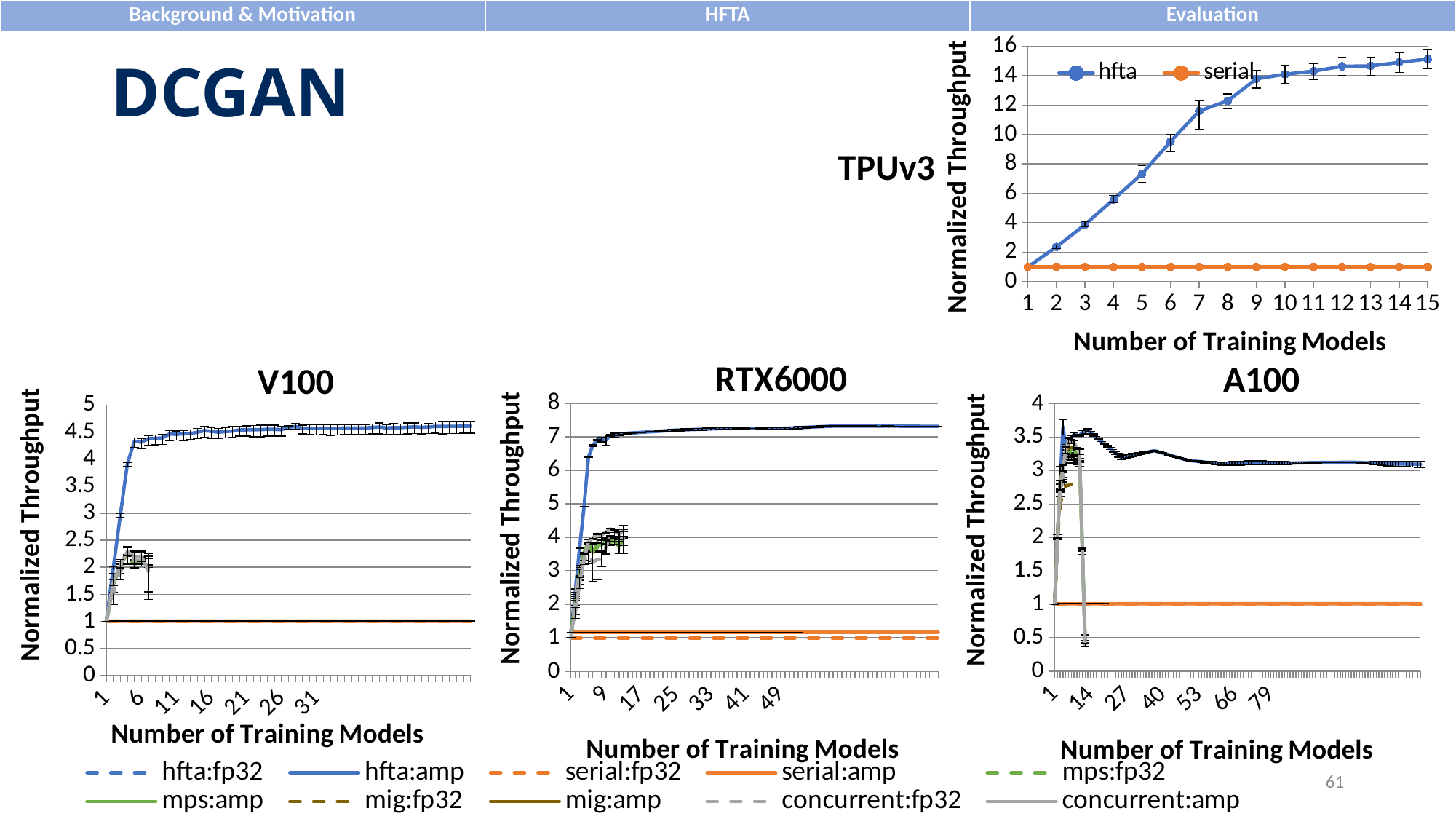
In the TPUv3 chart, is the hfta value at 15 training models greater or less than 14? greater How many series does the shared legend at the bottom of the slide list? 10 In the TPUv3 chart, is the hfta value at 6 training models greater or less than 8? greater In the TPUv3 chart, which series is larger at 10 training models, hfta or serial? hfta How many series does the legend of the TPUv3 chart list? 2 In the RTX6000 chart, is the hfta:amp value at 49 training models greater or less than 7? greater What is the y-axis label of the V100 chart? Normalized Throughput In the TPUv3 chart, how many points are plotted along the x axis for each series? 15 What kind of chart is the TPUv3 chart? line chart In the TPUv3 chart, does the hfta series rise or fall as the number of training models increases? rises